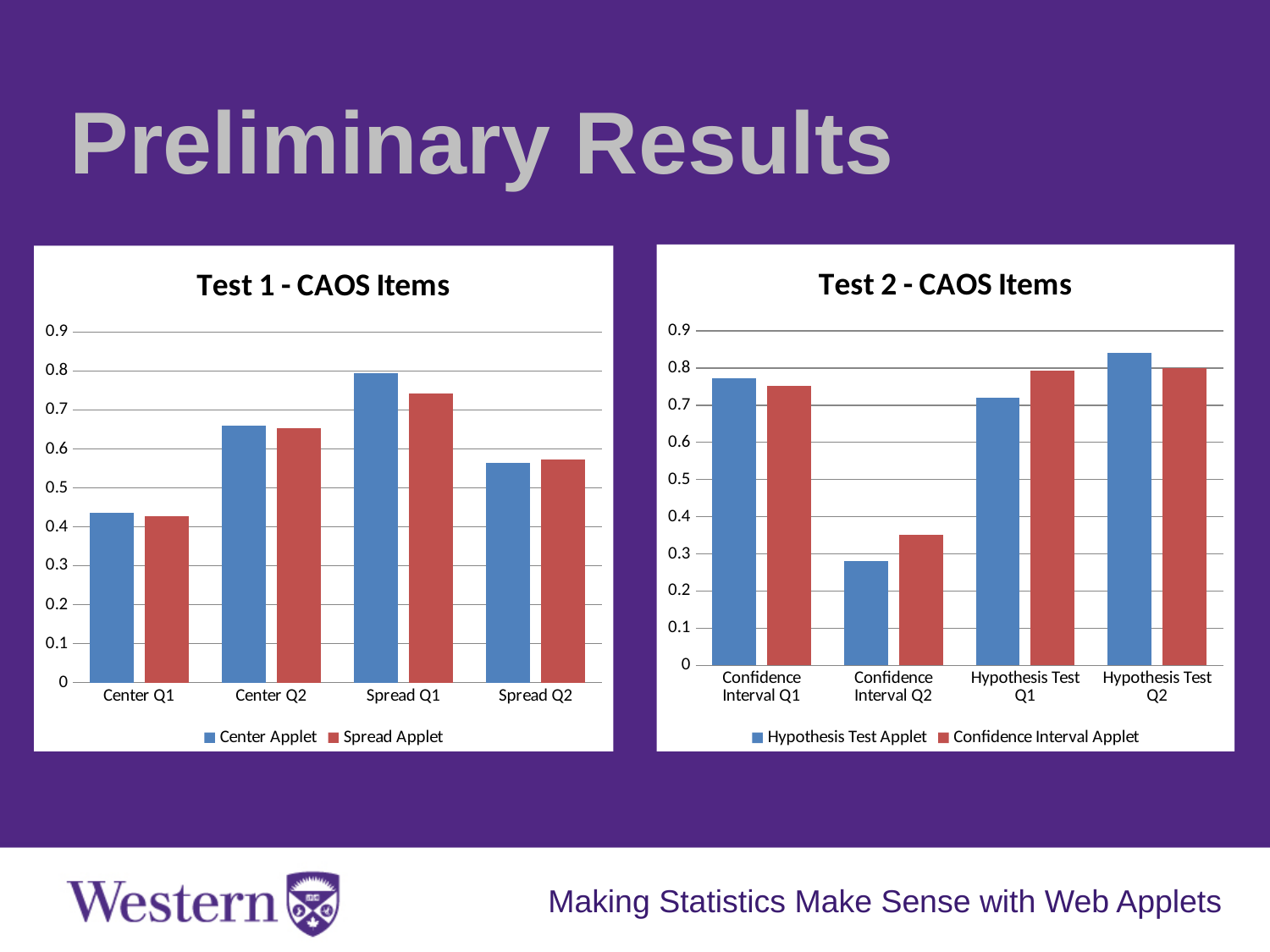
What kind of chart is the "Test 1 - CAOS Items" chart? bar chart In the "Test 2 - CAOS Items" chart, is the Hypothesis Test Applet value for Confidence Interval Q2 greater or less than 0.3? less In the "Test 2 - CAOS Items" chart, which category has the lowest value for Hypothesis Test Applet? Confidence Interval Q2 In the "Test 2 - CAOS Items" chart, which category has the highest value for Hypothesis Test Applet? Hypothesis Test Q2 In the "Test 2 - CAOS Items" chart, for Hypothesis Test Q1, which series has the larger value: Hypothesis Test Applet or Confidence Interval Applet? Confidence Interval Applet How many categories are shown on the x axis of the "Test 1 - CAOS Items" chart? 4 What are the two legend entries of the "Test 2 - CAOS Items" chart? Hypothesis Test Applet and Confidence Interval Applet In the "Test 1 - CAOS Items" chart, is the Center Applet value for Spread Q1 greater or less than 0.7? greater In the "Test 1 - CAOS Items" chart, which category has the lowest value for Spread Applet? Center Q1 In the "Test 1 - CAOS Items" chart, for Spread Q1, which series has the larger value: Center Applet or Spread Applet? Center Applet In the "Test 1 - CAOS Items" chart, which category has the highest value for Center Applet? Spread Q1 How many series does the legend of the "Test 1 - CAOS Items" chart list? 2